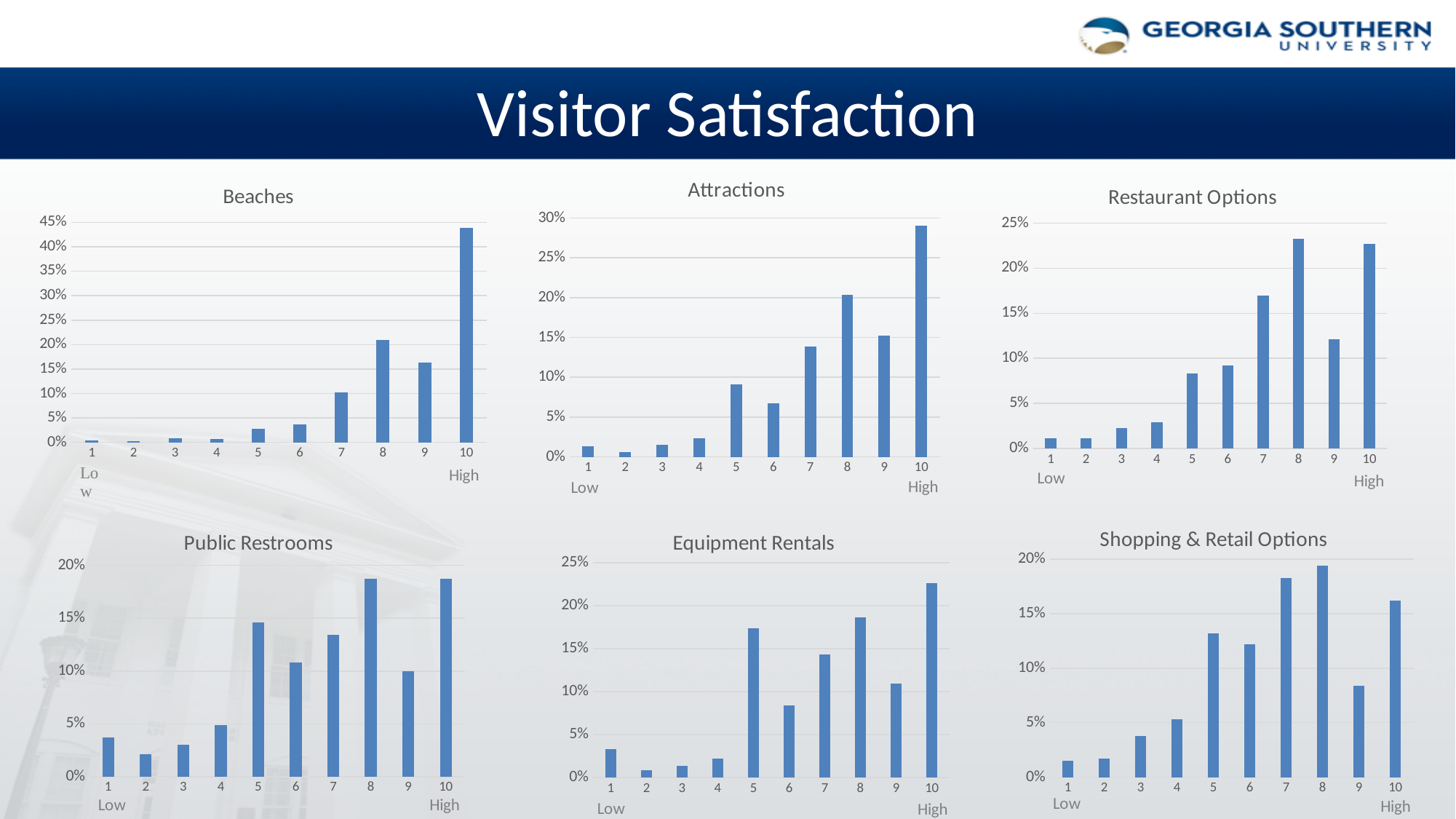
In the Shopping & Retail Options chart, is the value for rating 9 greater or less than 10%? less How many rating categories are shown on the x axis of the Equipment Rentals chart? 10 In the Attractions chart, which is larger, the value for rating 8 or rating 9? 8 In the Beaches chart, which rating category has the highest value? 10 In the Restaurant Options chart, which is larger, the value for rating 7 or rating 9? 7 In the Restaurant Options chart, is the value for rating 9 greater or less than 15%? less In the Public Restrooms chart, which is larger, the value for rating 5 or rating 6? 5 In the Attractions chart, which rating category has the highest value? 10 In the Beaches chart, do the values generally rise or fall as the rating goes from 1 to 10? rise In the Equipment Rentals chart, which rating category has the highest value? 10 What kind of chart is the Public Restrooms chart? bar chart In the Beaches chart, is the value for rating 10 greater or less than 40%? greater